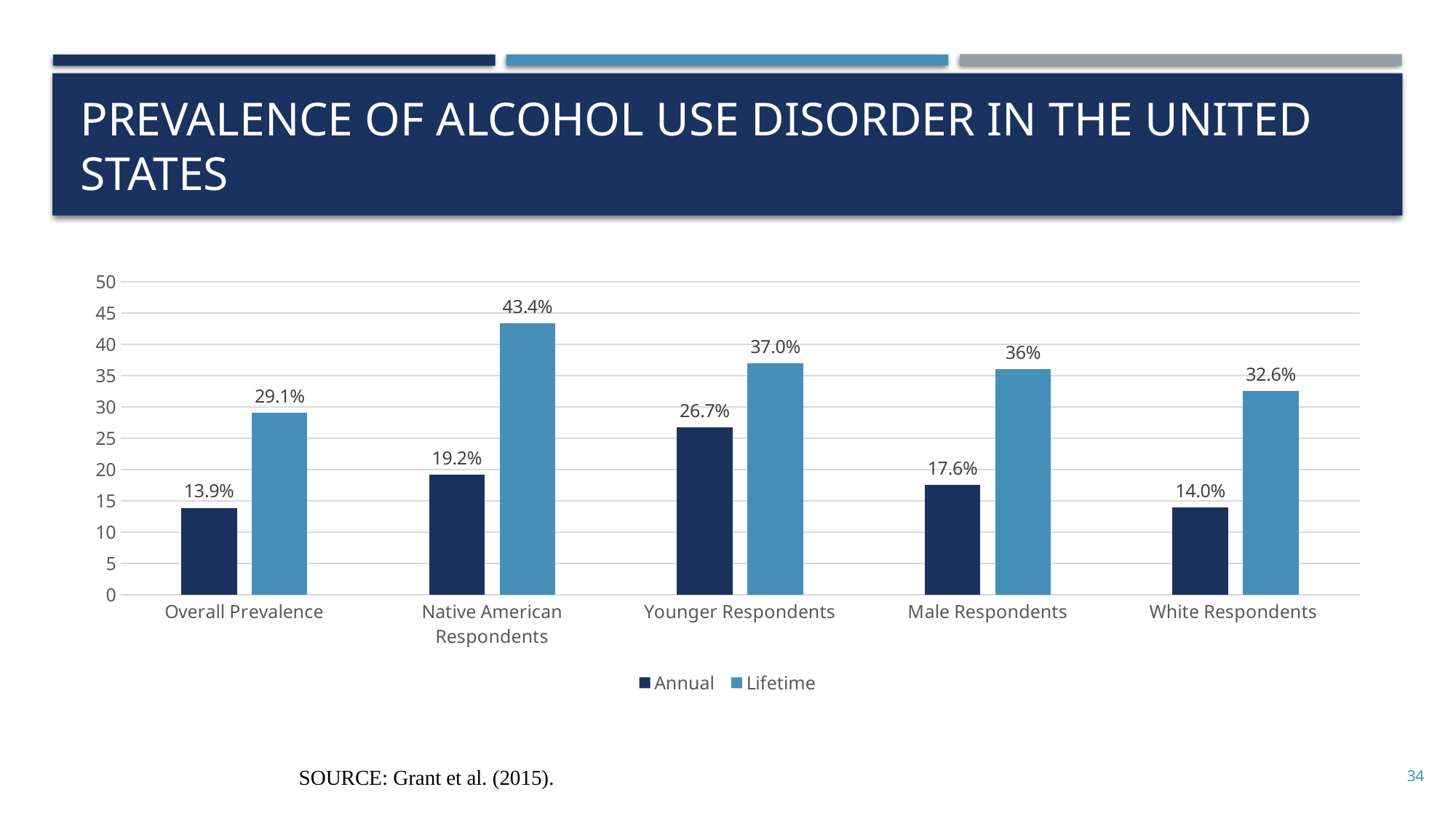
Which category has the lowest Annual value? Overall Prevalence Is the Lifetime value for Overall Prevalence greater or less than 25? greater Which category has the highest Lifetime value? Native American Respondents What is the Annual value for Younger Respondents? 26.7% What is the title of the slide? Prevalence of Alcohol Use Disorder in the United States What is the difference between the Lifetime and Annual values for Male Respondents? 18.4% What kind of chart is shown on the slide? Bar chart Which is larger, the Lifetime value for Younger Respondents or the Lifetime value for Male Respondents? Younger Respondents What is the Annual value for Native American Respondents? 19.2% How many series does the legend list? 2 What is the Lifetime value for White Respondents? 32.6% How many categories are shown on the x axis? 5